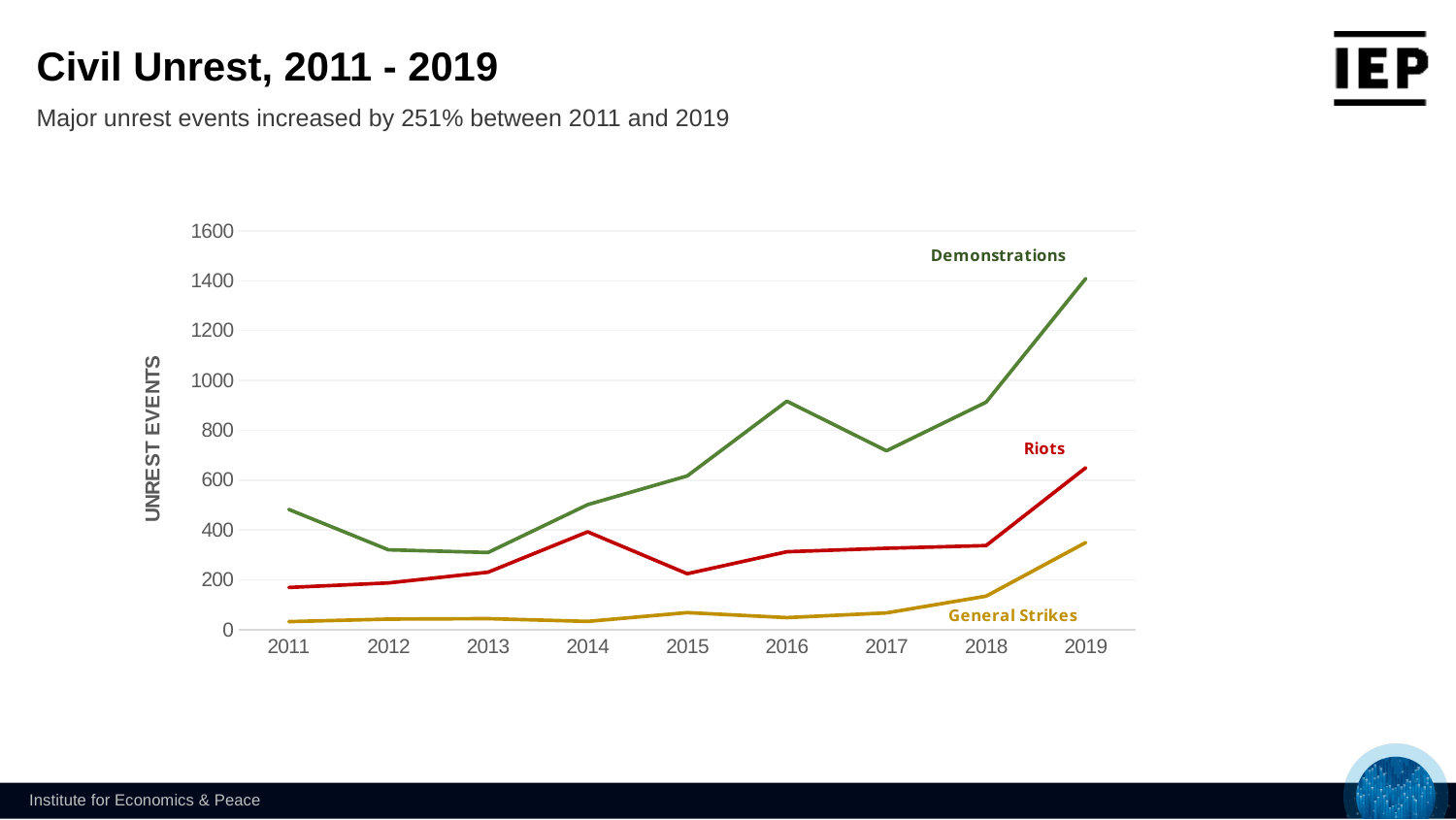
Is the value for Riots in 2011 greater or less than 200? less Do Demonstrations rise or fall between 2017 and 2019? Rise Is the value for General Strikes in 2019 greater or less than 200? greater Is the value for Demonstrations in 2017 greater or less than 800? less In which year do Riots reach their highest value? 2019 How many series are labelled on the chart? 3 What kind of chart is shown on the slide? Line chart How many years are shown along the x axis? 9 What is the label on the y axis of the chart? UNREST EVENTS In which year do Demonstrations reach their highest value? 2019 Which series has the larger value in 2019, Demonstrations or Riots? Demonstrations